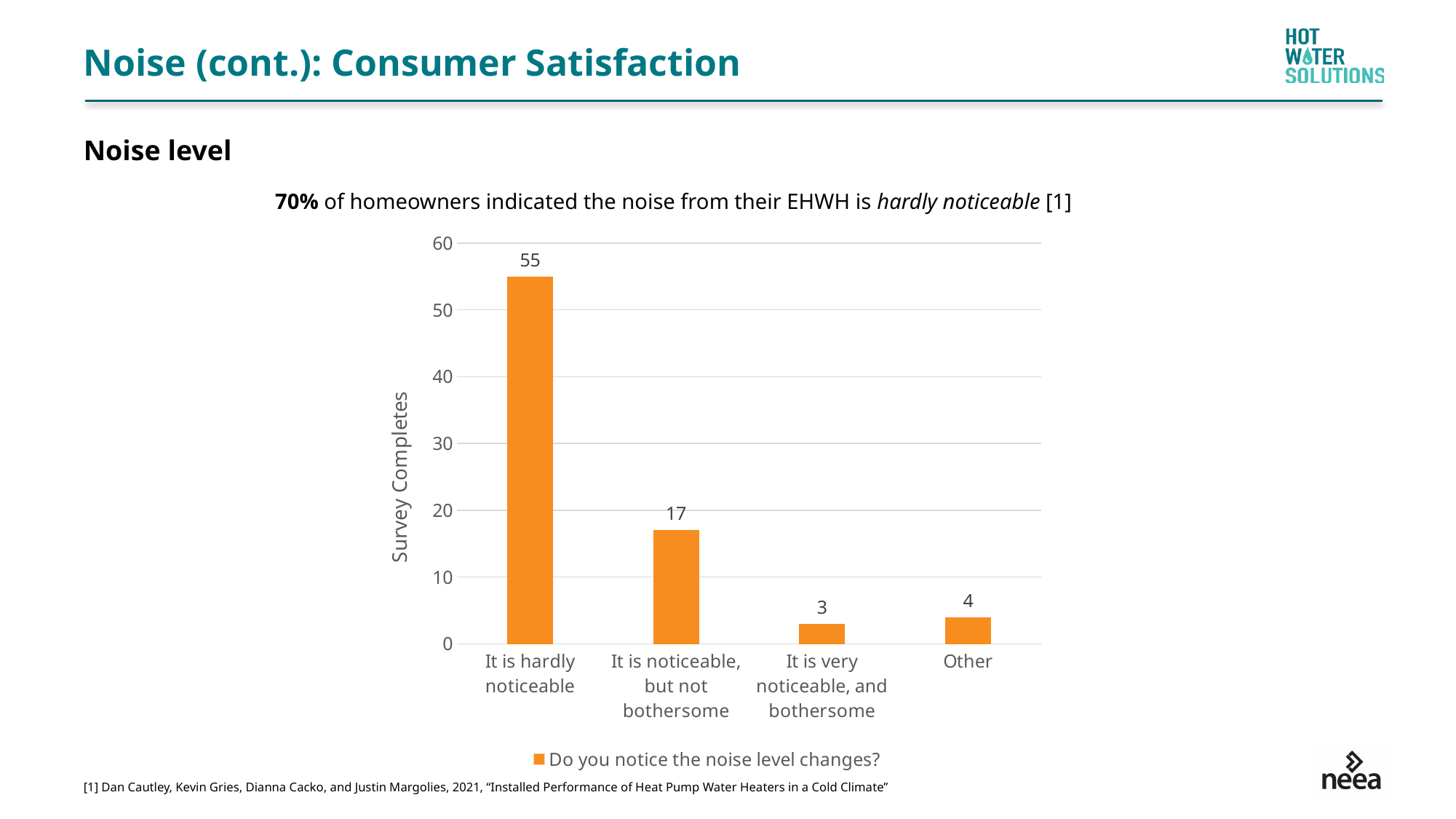
What is the value for "It is noticeable, but not bothersome"? 17 What is the value for the "Other" category? 4 What kind of chart is shown on the slide? Bar chart Which is larger, the value for "Other" or the value for "It is very noticeable, and bothersome"? Other What is the value for "It is very noticeable, and bothersome"? 3 Is the value for "It is noticeable, but not bothersome" greater or less than 20? less How many categories are shown on the x axis of the chart? 4 What is the label on the y axis of the chart? Survey Completes Which category has the highest number of survey completes? It is hardly noticeable Which category has the lowest number of survey completes? It is very noticeable, and bothersome How many survey completes are shown for "It is hardly noticeable"? 55 What is the difference between the values for "It is hardly noticeable" and "It is noticeable, but not bothersome"? 38